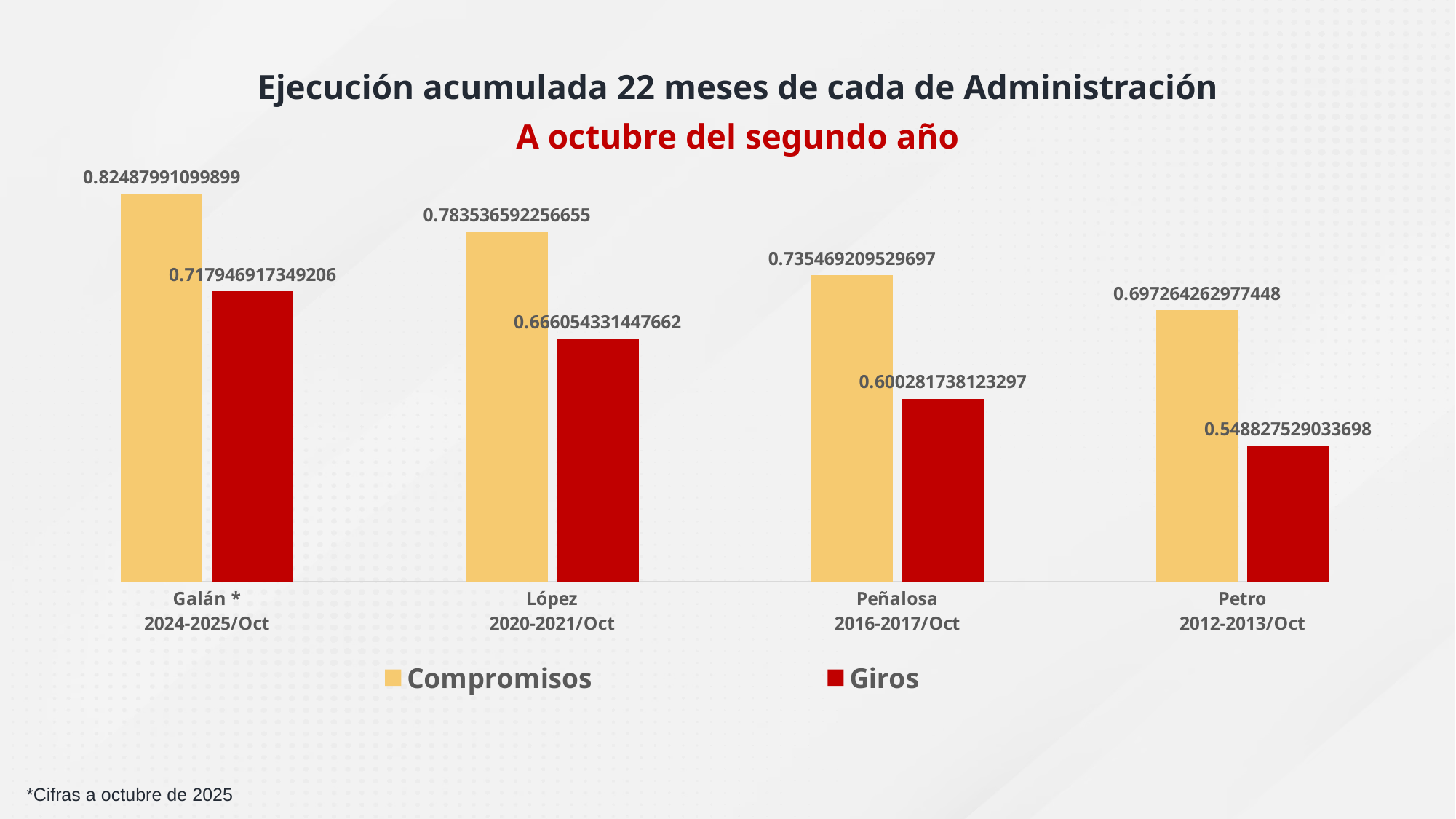
Do the Compromisos values rise or fall from Galán * to Petro along the x axis? Fall How many administrations are shown on the x axis? 4 Which administration has the larger Giros value: López or Peñalosa? López Which administration has the highest Compromisos value? Galán * What kind of chart is shown on the slide? Bar chart What is the Compromisos value for Peñalosa? 0.735469209529697 What is the Giros value for Petro? 0.548827529033698 What is the Giros value for López? 0.666054331447662 What is the Compromisos value for Galán *? 0.82487991099899 How many series does the legend list? 2 Which administration has the lowest Giros value? Petro Which is larger for Peñalosa: Compromisos or Giros? Compromisos